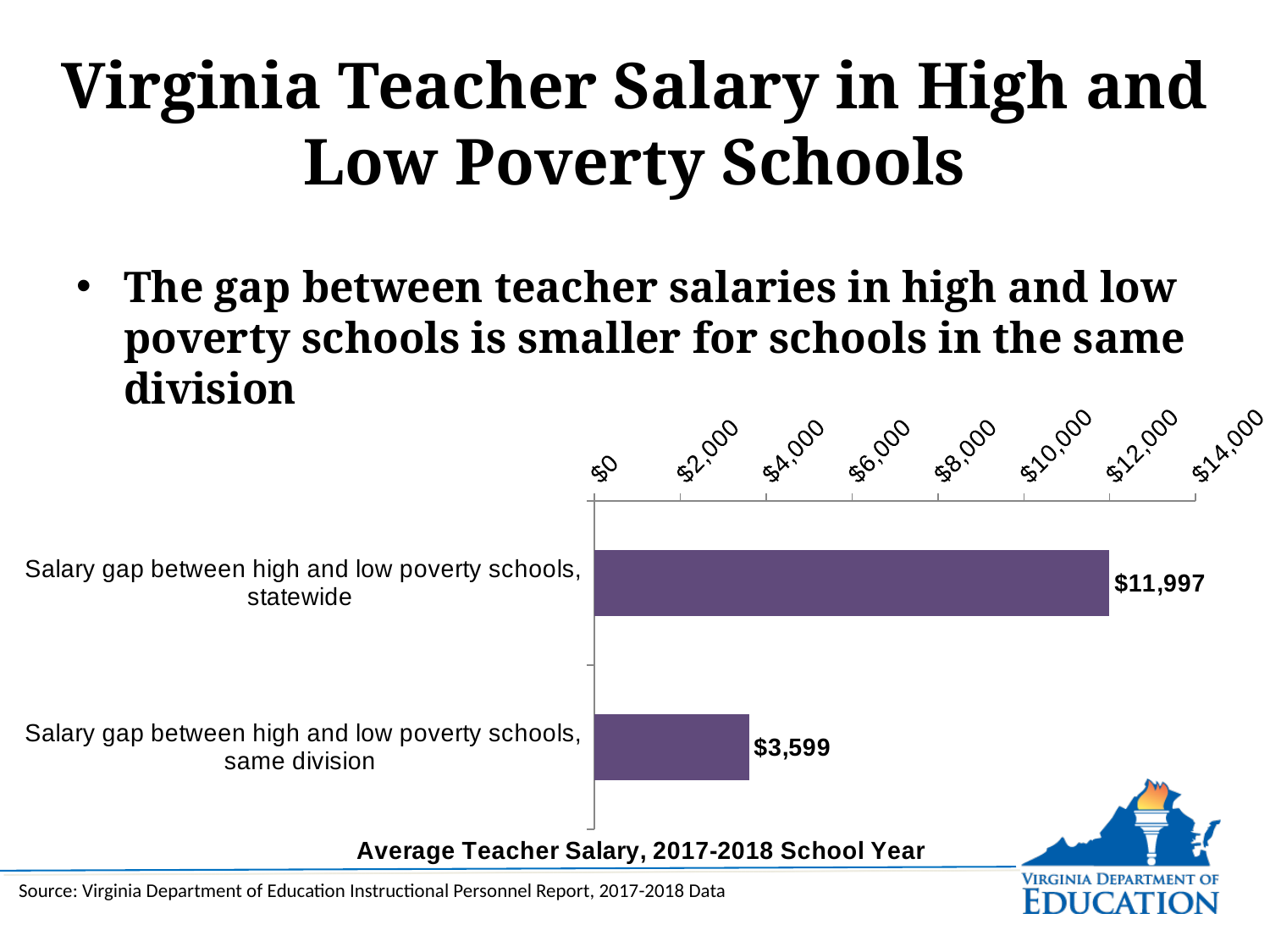
What is the difference between the statewide salary gap and the same-division salary gap? $8,398 What is the salary gap between high and low poverty schools statewide? $11,997 What is the title shown below the chart? Average Teacher Salary, 2017-2018 School Year Is the statewide salary gap larger or smaller than the same-division salary gap? larger What is the highest value labelled on the chart's axis? $14,000 Which category has the smaller salary gap? Salary gap between high and low poverty schools, same division Is the value for the statewide salary gap greater or less than $10,000? greater Which category has the larger salary gap? Salary gap between high and low poverty schools, statewide What kind of chart is shown on the slide? bar chart How many categories are shown in the chart? 2 Is the value for the same-division salary gap greater or less than $4,000? less What is the salary gap between high and low poverty schools in the same division? $3,599